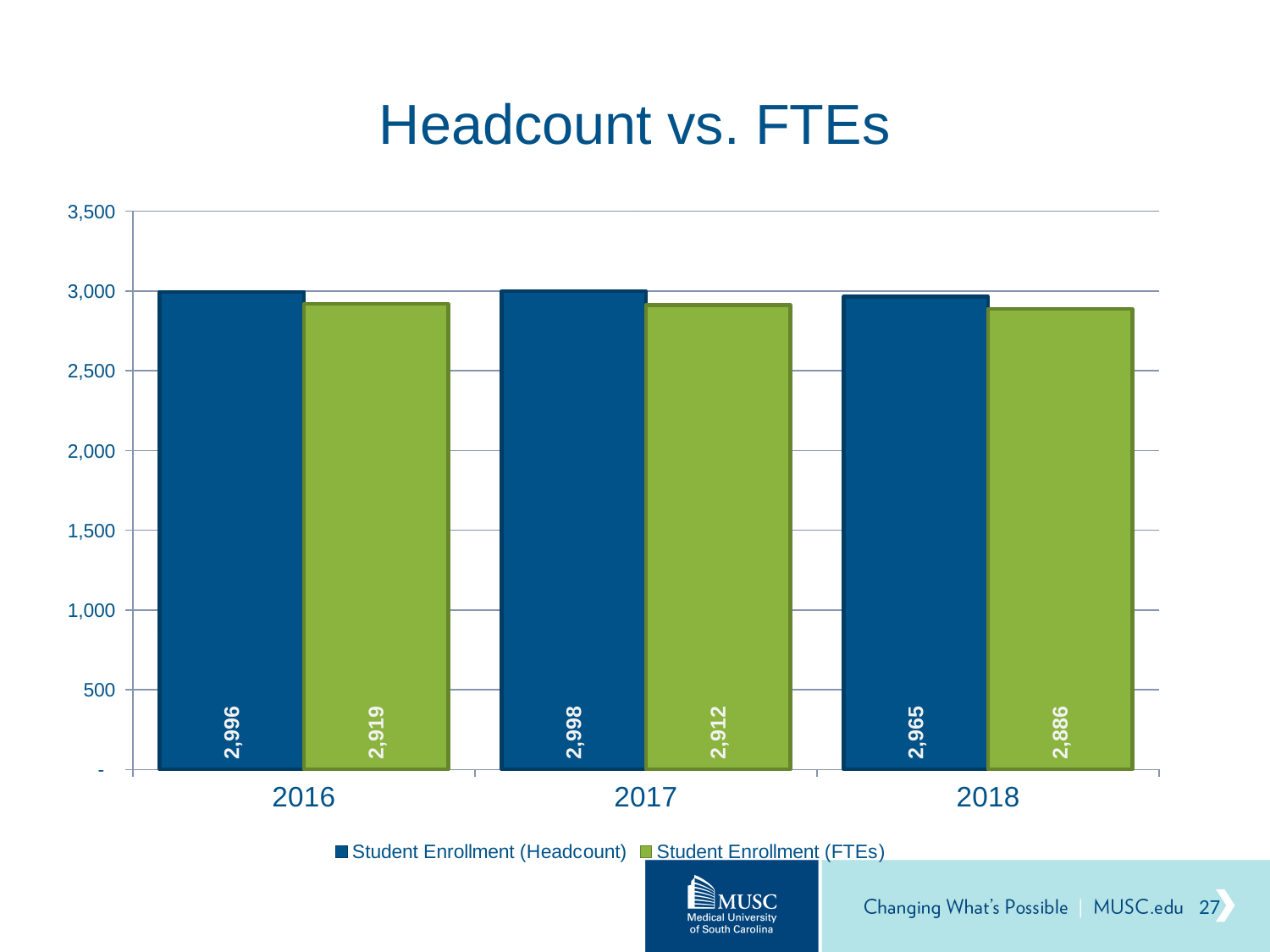
Which year has the lowest Student Enrollment (FTEs)? 2018 What is the Student Enrollment (Headcount) value for 2016? 2,996 What is the Student Enrollment (FTEs) value for 2017? 2,912 What kind of chart is shown on the slide? Bar chart What is the difference between Headcount and FTEs in 2018? 79 Which year has the highest Student Enrollment (Headcount)? 2017 Which is larger in 2016, Student Enrollment (Headcount) or Student Enrollment (FTEs)? Student Enrollment (Headcount) What is the Student Enrollment (FTEs) value for 2018? 2,886 How many years are shown on the x axis? 3 What is the title of the chart? Headcount vs. FTEs What is the difference between the Headcount values for 2017 and 2016? 2 How many series does the legend list? 2